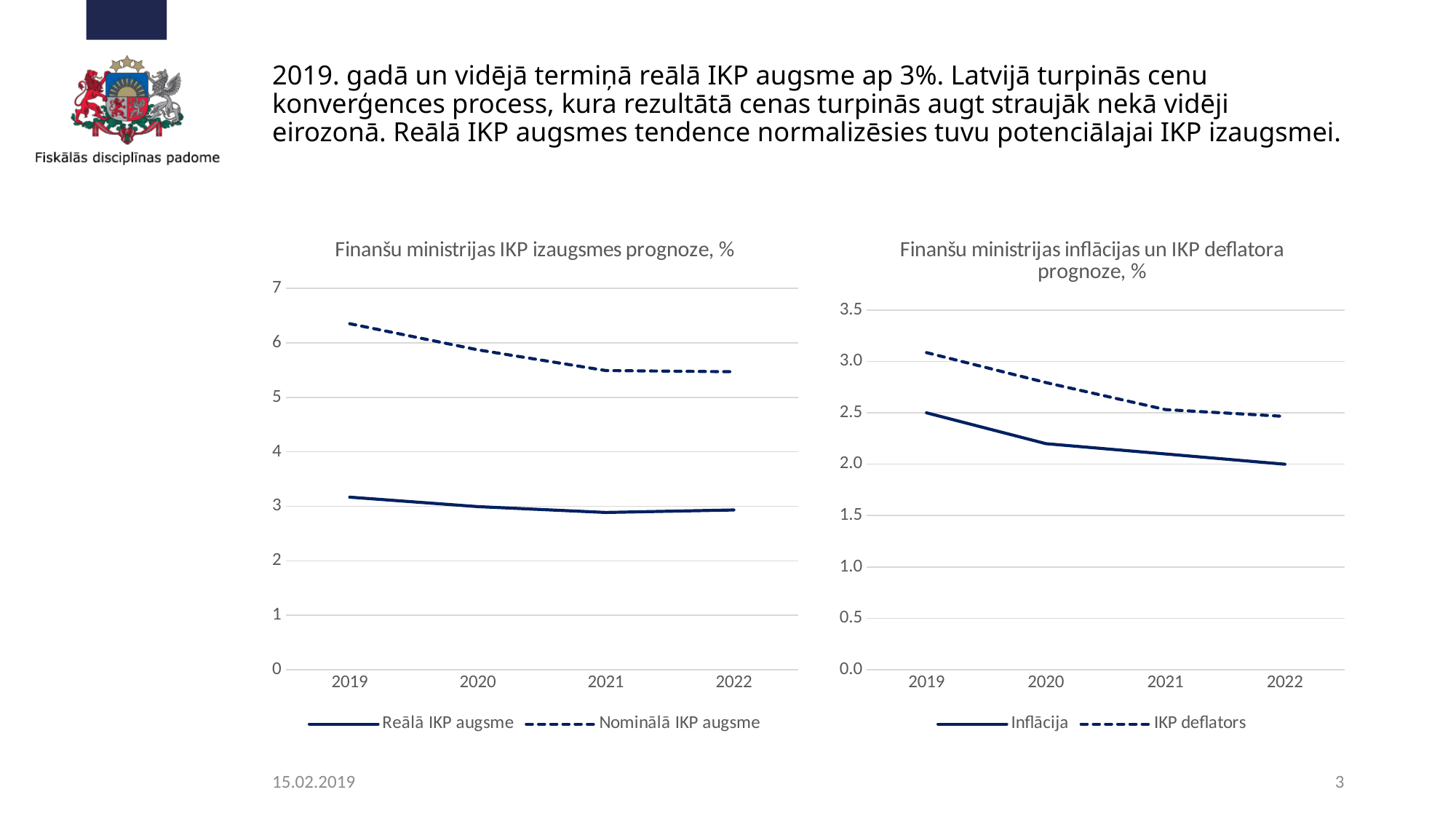
In "Finanšu ministrijas IKP izaugsmes prognoze, %", does Nominālā IKP augsme rise or fall from 2019 to 2021? fall In "Finanšu ministrijas IKP izaugsmes prognoze, %", is the value of Nominālā IKP augsme in 2019 greater or less than 6? greater In "Finanšu ministrijas IKP izaugsmes prognoze, %", is the value of Reālā IKP augsme in 2021 greater or less than 3? less How many series does the legend of "Finanšu ministrijas inflācijas un IKP deflatora prognoze, %" list? 2 In "Finanšu ministrijas inflācijas un IKP deflatora prognoze, %", does Inflācija rise or fall from 2019 to 2022? fall In "Finanšu ministrijas IKP izaugsmes prognoze, %", in which year is Nominālā IKP augsme highest? 2019 In "Finanšu ministrijas inflācijas un IKP deflatora prognoze, %", is the value of IKP deflators in 2019 greater or less than 3.0? greater In "Finanšu ministrijas IKP izaugsmes prognoze, %", which series is drawn with a dashed line? Nominālā IKP augsme What kind of chart is "Finanšu ministrijas IKP izaugsmes prognoze, %"? line chart How many years are shown on the x axis of "Finanšu ministrijas IKP izaugsmes prognoze, %"? 4 In "Finanšu ministrijas inflācijas un IKP deflatora prognoze, %", in which year is Inflācija lowest? 2022 In "Finanšu ministrijas inflācijas un IKP deflatora prognoze, %", which series is higher in 2022, Inflācija or IKP deflators? IKP deflators